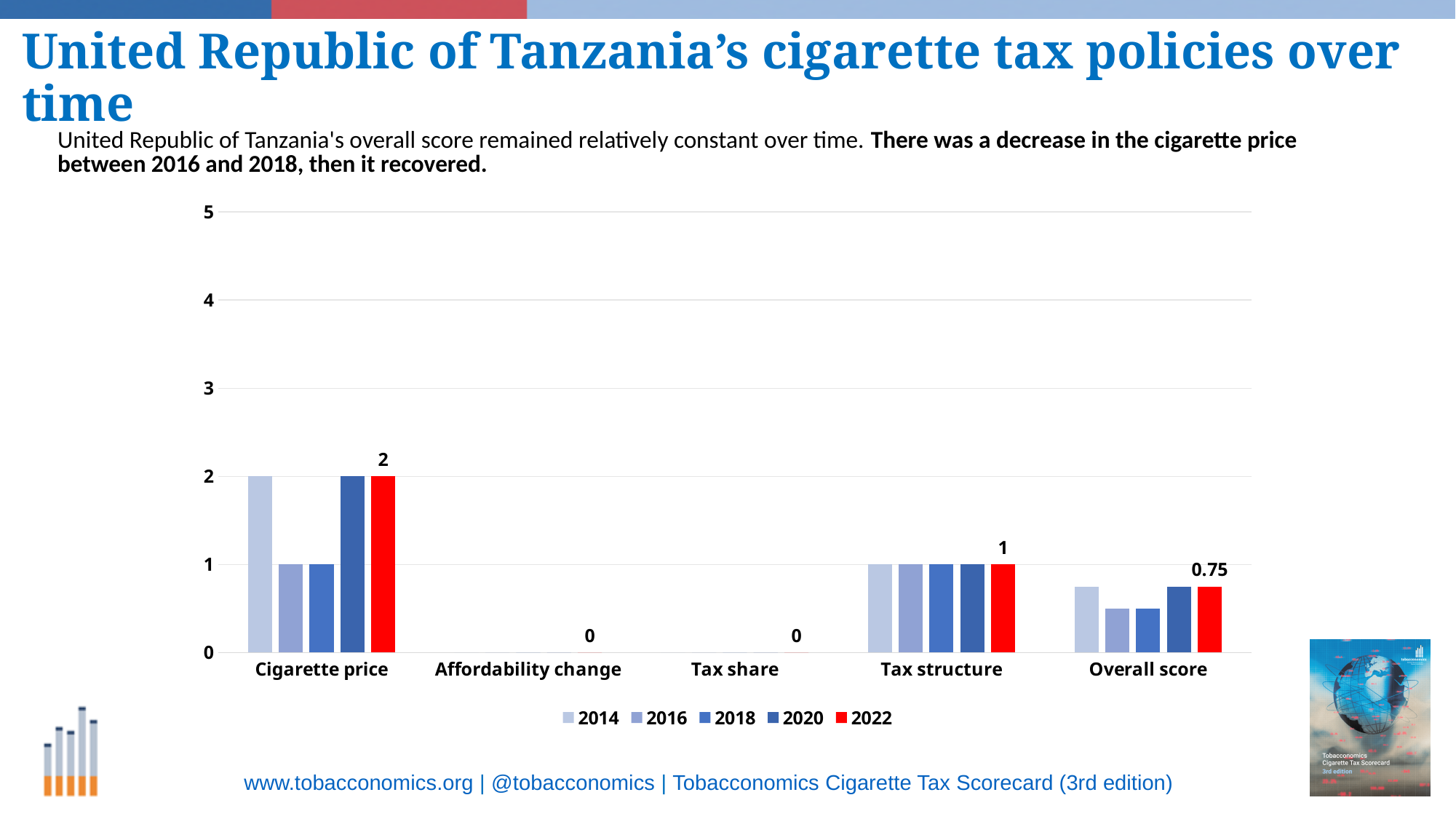
Which category has the highest 2022 value? Cigarette price What is the 2022 value for Affordability change? 0 Is the 2016 value for Overall score greater or less than 1? less What is the 2022 value for Tax structure? 1 How many series does the legend list? 5 What is the difference between the 2022 values for Cigarette price and Tax structure? 1 How many categories are shown on the x axis? 5 What is the 2016 value for Cigarette price? 1 What is the 2022 value for Cigarette price? 2 Is the 2022 value for Cigarette price larger than the 2022 value for Overall score? Yes What kind of chart is shown on the slide? Bar chart What is the 2022 value for Overall score? 0.75